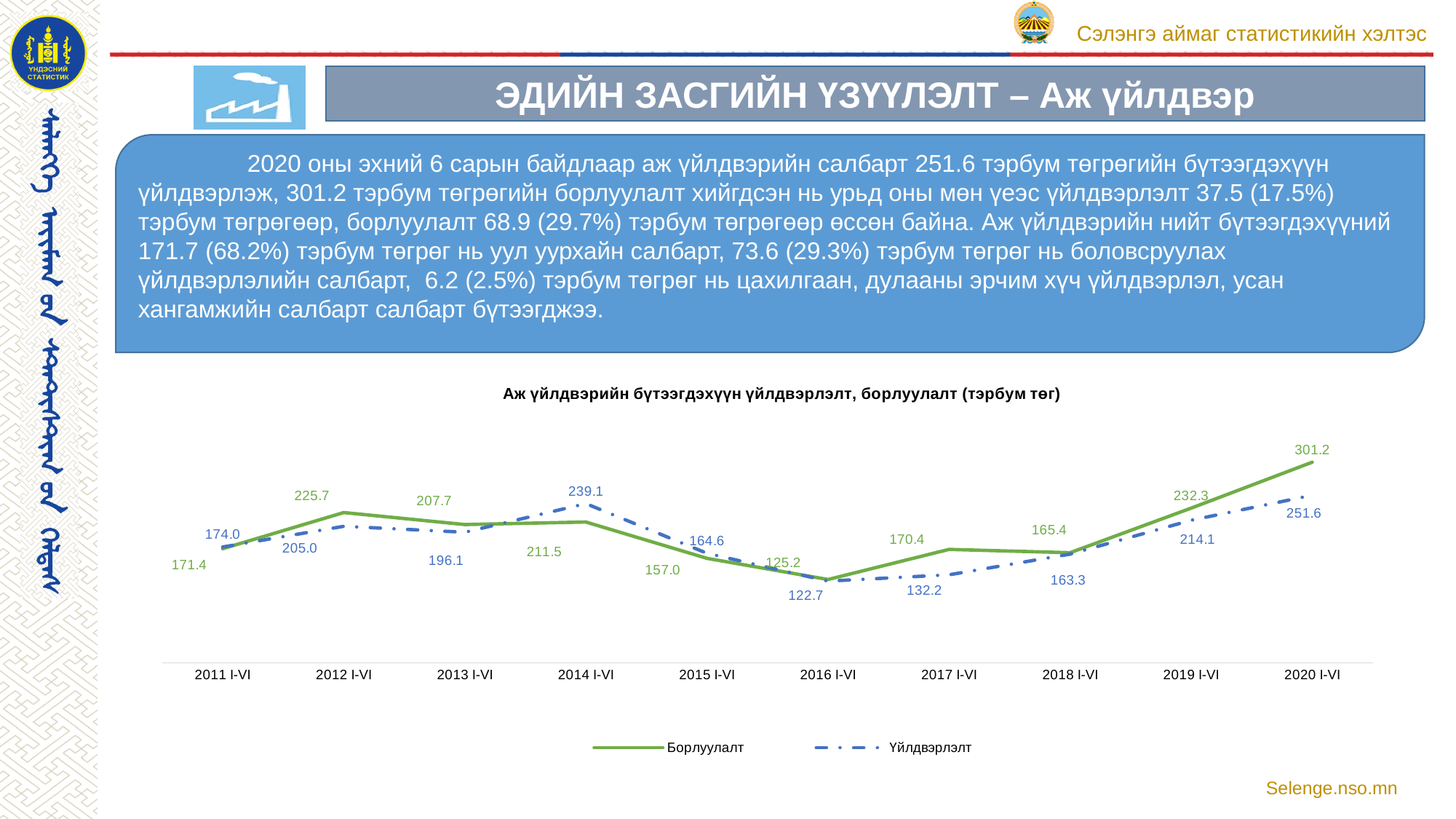
What is the value of Үйлдвэрлэлт for 2014 I-VI? 239.1 How many series does the legend list? 2 What type of chart is shown on the slide? line chart What is the difference between Борлуулалт and Үйлдвэрлэлт in 2020 I-VI? 49.6 What is the value of Борлуулалт for 2020 I-VI? 301.2 What is the title of the chart? Аж үйлдвэрийн бүтээгдэхүүн үйлдвэрлэлт, борлуулалт (тэрбум төг) Does Борлуулалт rise or fall from 2016 I-VI to 2020 I-VI? rise Which is larger in 2014 I-VI, Борлуулалт or Үйлдвэрлэлт? Үйлдвэрлэлт How many time periods are plotted along the x axis? 10 In which period is Борлуулалт lowest? 2016 I-VI In which period is Үйлдвэрлэлт highest? 2020 I-VI What is the value of Үйлдвэрлэлт for 2017 I-VI? 132.2